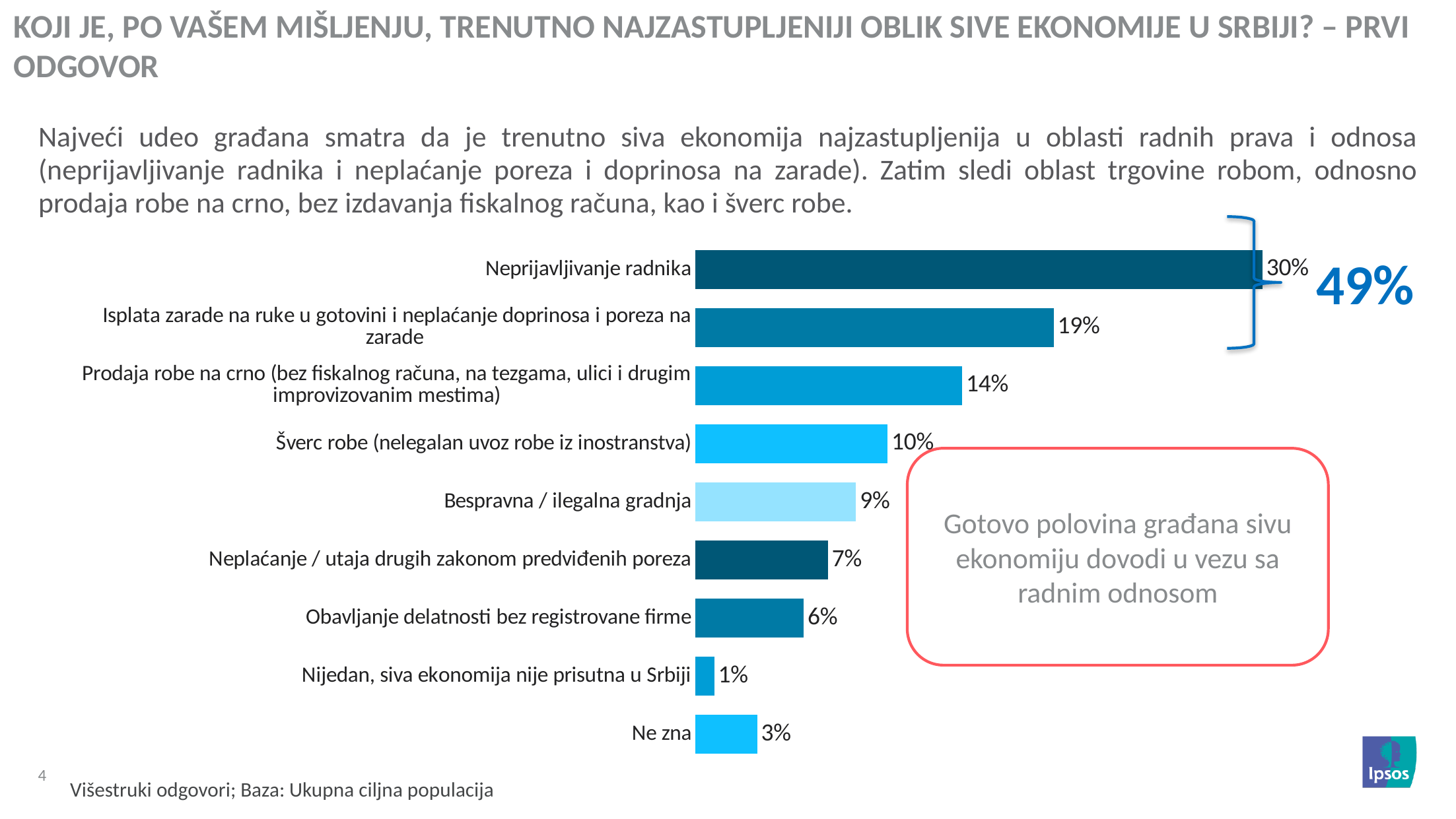
What is the combined value of the two categories grouped by the bracket on the right of the chart? 49% What is the difference between the values for "Neplaćanje / utaja drugih zakonom predviđenih poreza" and "Nijedan, siva ekonomija nije prisutna u Srbiji"? 6% What is the difference between the values for "Neprijavljivanje radnika" and "Isplata zarade na ruke u gotovini i neplaćanje doprinosa i poreza na zarade"? 11% What percentage is shown for "Neprijavljivanje radnika"? 30% What percentage is shown for "Ne zna"? 3% Which category has the lowest value in the chart? Nijedan, siva ekonomija nije prisutna u Srbiji Which category has the highest value in the chart? Neprijavljivanje radnika What kind of chart is shown on the slide? Bar chart Which is larger: the value for "Bespravna / ilegalna gradnja" or for "Obavljanje delatnosti bez registrovane firme"? Bespravna / ilegalna gradnja How many categories are shown in the chart? 9 What value is shown for "Prodaja robe na crno (bez fiskalnog računa, na tezgama, ulici i drugim improvizovanim mestima)"? 14% What value is shown for "Šverc robe (nelegalan uvoz robe iz inostranstva)"? 10%